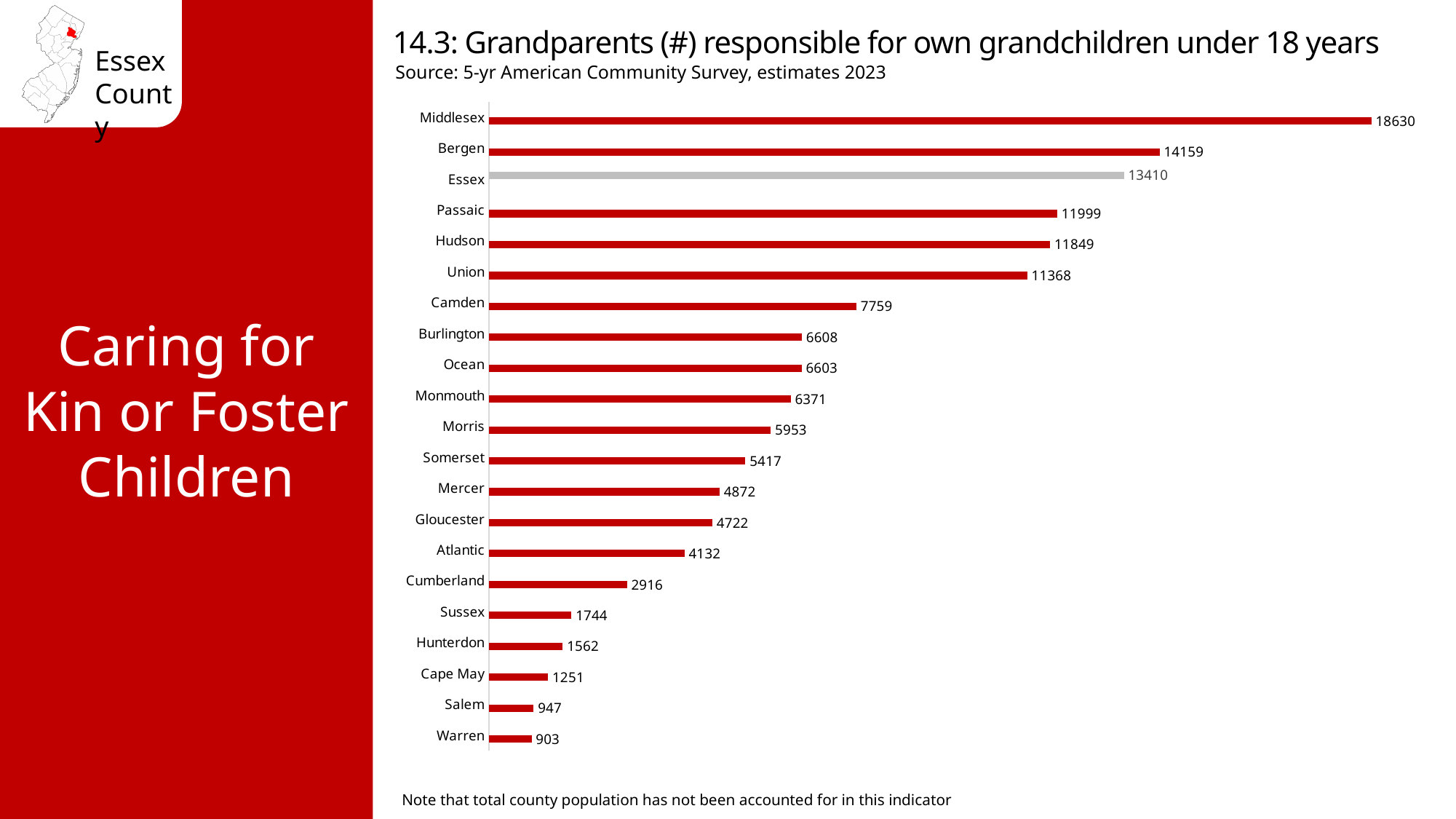
What value is shown for Camden? 7759 What is the number of grandparents responsible for own grandchildren in Essex County? 13410 How many counties are shown on the chart? 21 What is the difference between the values for Middlesex and Bergen? 4471 Which county's bar is coloured grey instead of red? Essex Which county has the lowest value on the chart? Warren What value is shown for Cumberland? 2916 What is the difference between the values for Essex and Union? 2042 Which county has the highest number of grandparents responsible for own grandchildren? Middlesex What type of chart is shown on the slide? Bar chart Which has a larger value, Sussex or Hunterdon? Sussex Which has a larger value, Passaic or Hudson? Passaic